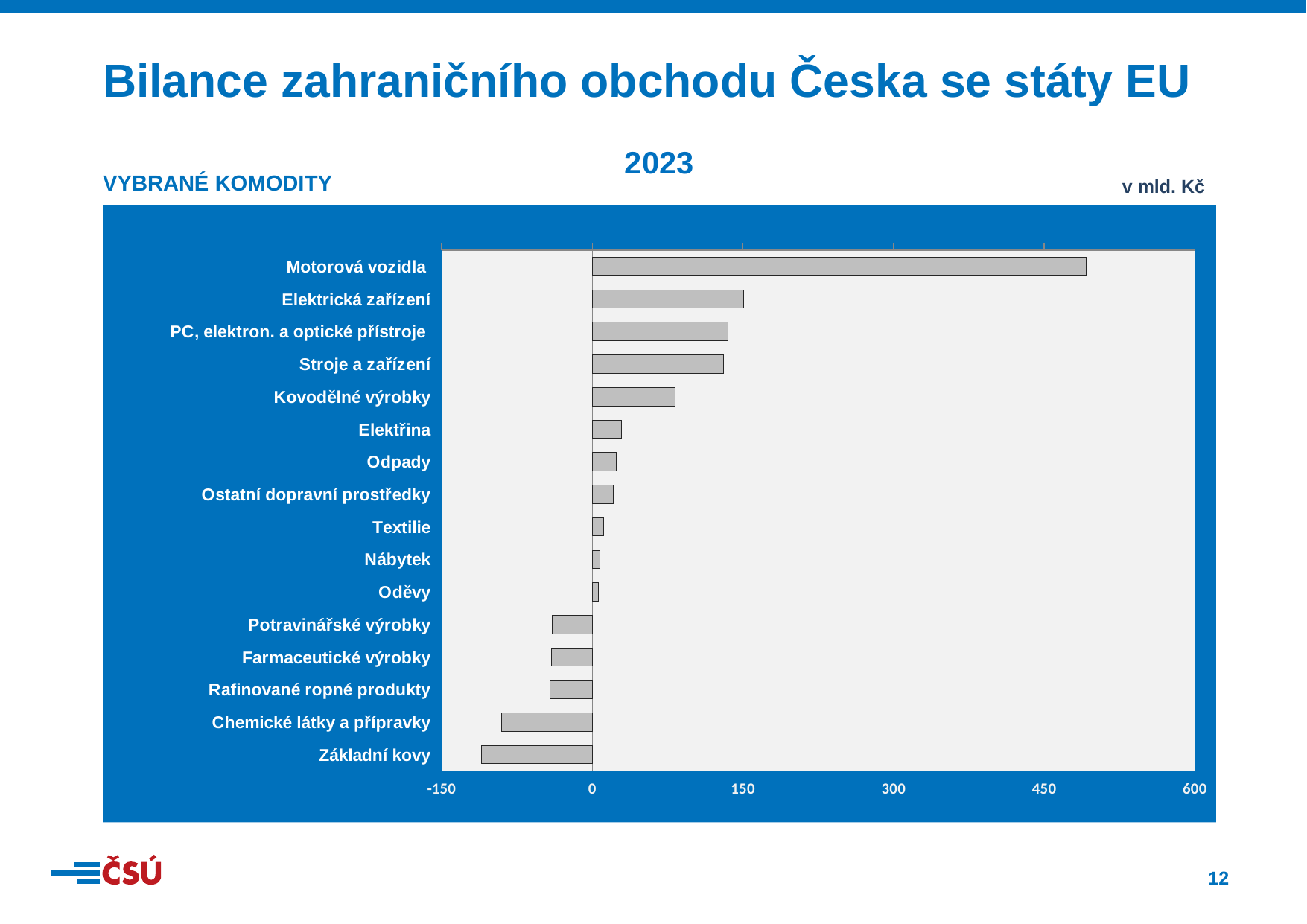
How many commodity categories are plotted in the chart? 16 What unit is stated for the values in the chart? v mld. Kč Which commodity has the lowest trade balance in the chart? Základní kovy Which commodity has the highest trade balance in the chart? Motorová vozidla Is the value for Základní kovy greater or less than 0? less Which is larger, the value for Motorová vozidla or the value for Kovodělné výrobky? Motorová vozidla Which is larger, the value for Elektřina or the value for Textilie? Elektřina Is the value for Chemické látky a přípravky greater or less than -150? greater Is the value for Kovodělné výrobky greater or less than 150? less Which year does the chart cover? 2023 What kind of chart is shown on the slide? bar chart